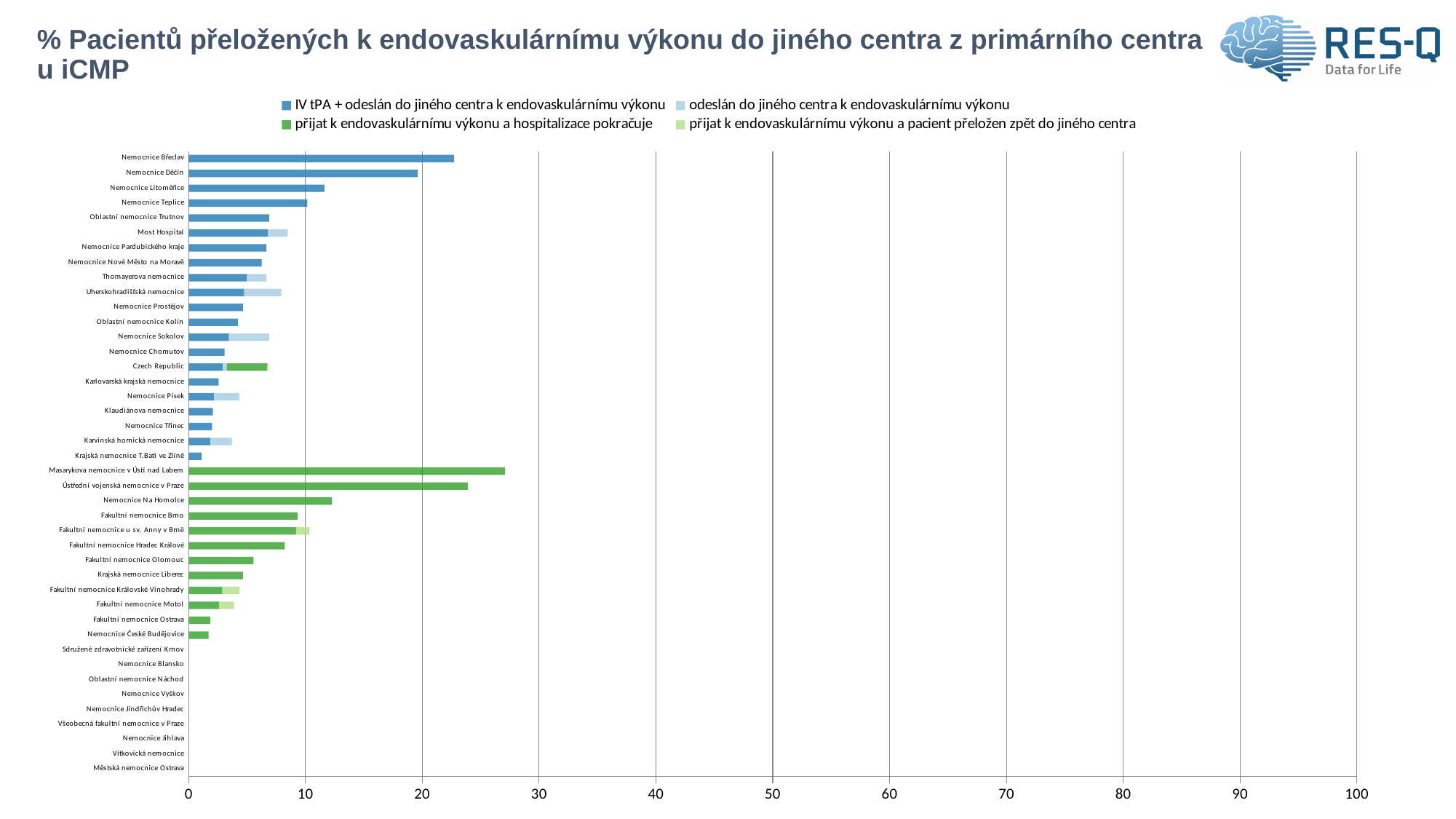
What is the highest value shown on the horizontal axis? 100 Is the value for Oblastní nemocnice Trutnov greater or less than 10? less Is the value for Masarykova nemocnice v Ústí nad Labem greater or less than 20? greater Which is larger, the bar for Nemocnice Břeclav or the bar for Nemocnice Děčín? Nemocnice Břeclav How many hospitals (categories) are listed on the vertical axis? 42 How many series does the legend list? 4 What kind of chart is shown on the slide? bar chart Is the value for Nemocnice Na Homolce greater or less than 10? greater Which is larger, the bar for Masarykova nemocnice v Ústí nad Labem or the bar for Ústřední vojenská nemocnice v Praze? Masarykova nemocnice v Ústí nad Labem Which hospital has the longest bar in the chart? Masarykova nemocnice v Ústí nad Labem